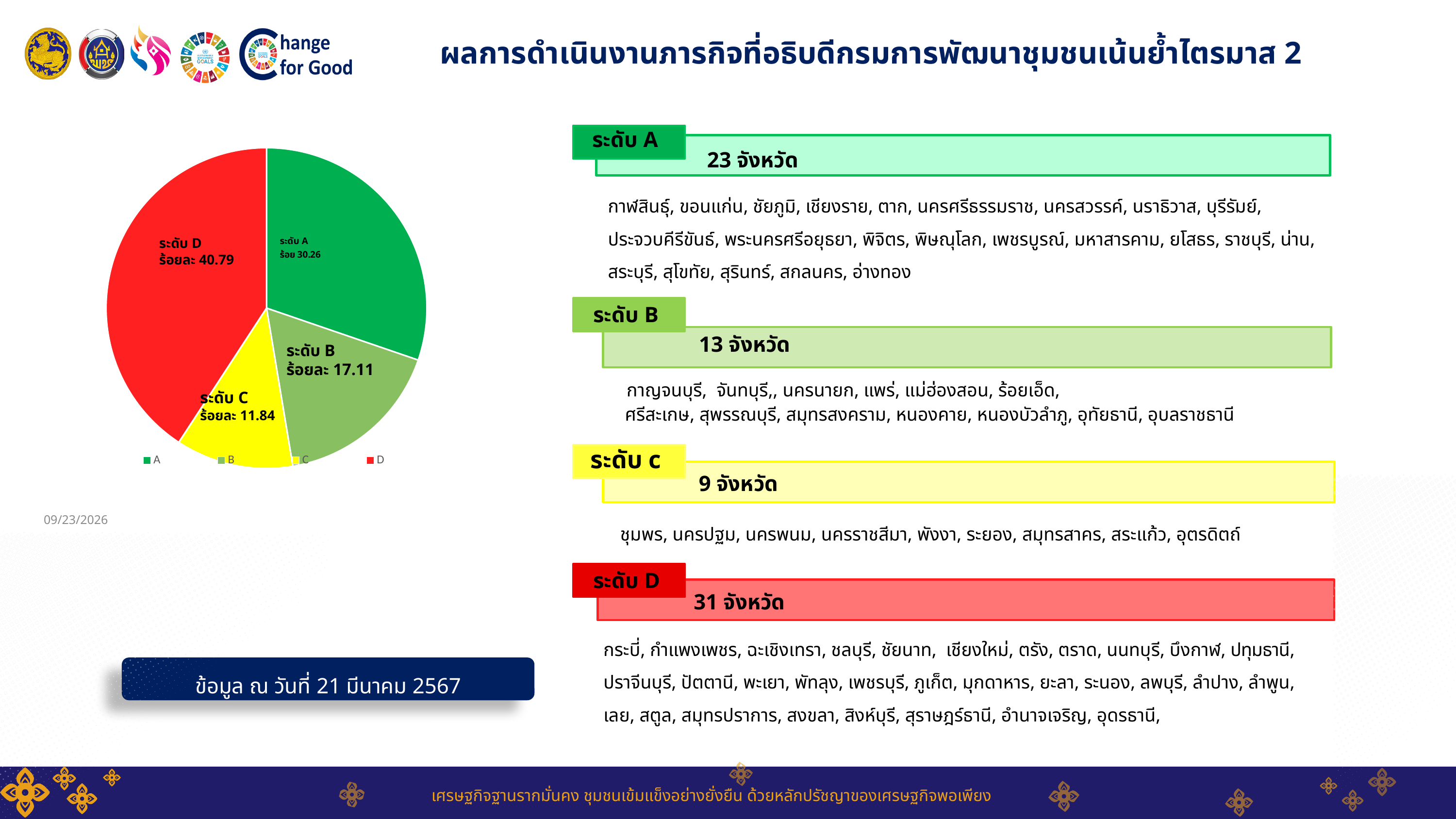
What is the value shown for ระดับ D in the pie chart? ร้อยละ 40.79 Which is larger in the pie chart, ระดับ A or ระดับ B? ระดับ A What is the value shown for ระดับ A in the pie chart? ร้อย 30.26 How many slices does the pie chart have? 4 What is the difference between the values for ระดับ D and ระดับ A in the pie chart? 10.53 What is the value shown for ระดับ B in the pie chart? ร้อยละ 17.11 How many entries does the pie chart legend list? 4 What kind of chart is shown on the slide? pie chart Which level has the smallest slice in the pie chart? ระดับ C What colour is the ระดับ D slice in the pie chart? red Which level has the largest slice in the pie chart? ระดับ D What is the value shown for ระดับ C in the pie chart? ร้อยละ 11.84